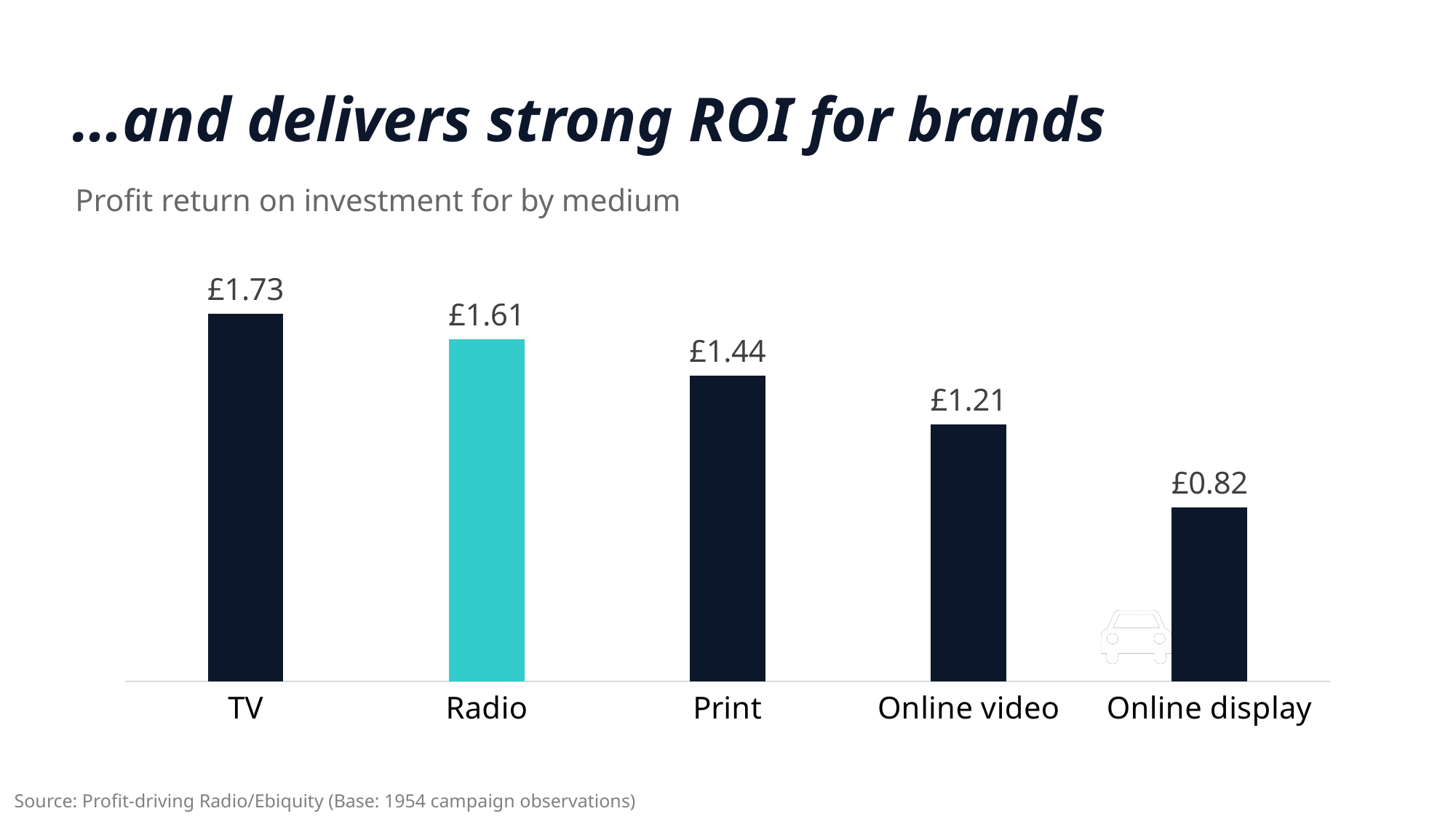
What is the profit return on investment for Online display? £0.82 Do the values rise or fall from left to right across the chart? Fall What is the difference between the ROI for Print and the ROI for Online video? £0.23 What is the difference between the ROI for TV and the ROI for Radio? £0.12 What kind of chart is shown on the slide? Bar chart Which medium has the highest profit return on investment? TV Which has a higher ROI, Radio or Print? Radio Which medium has the lowest profit return on investment? Online display Which bar is highlighted in a different colour (teal) from the others? Radio What is the profit return on investment for Print? £1.44 How many media are shown in the chart? 5 What is the profit return on investment for Radio? £1.61